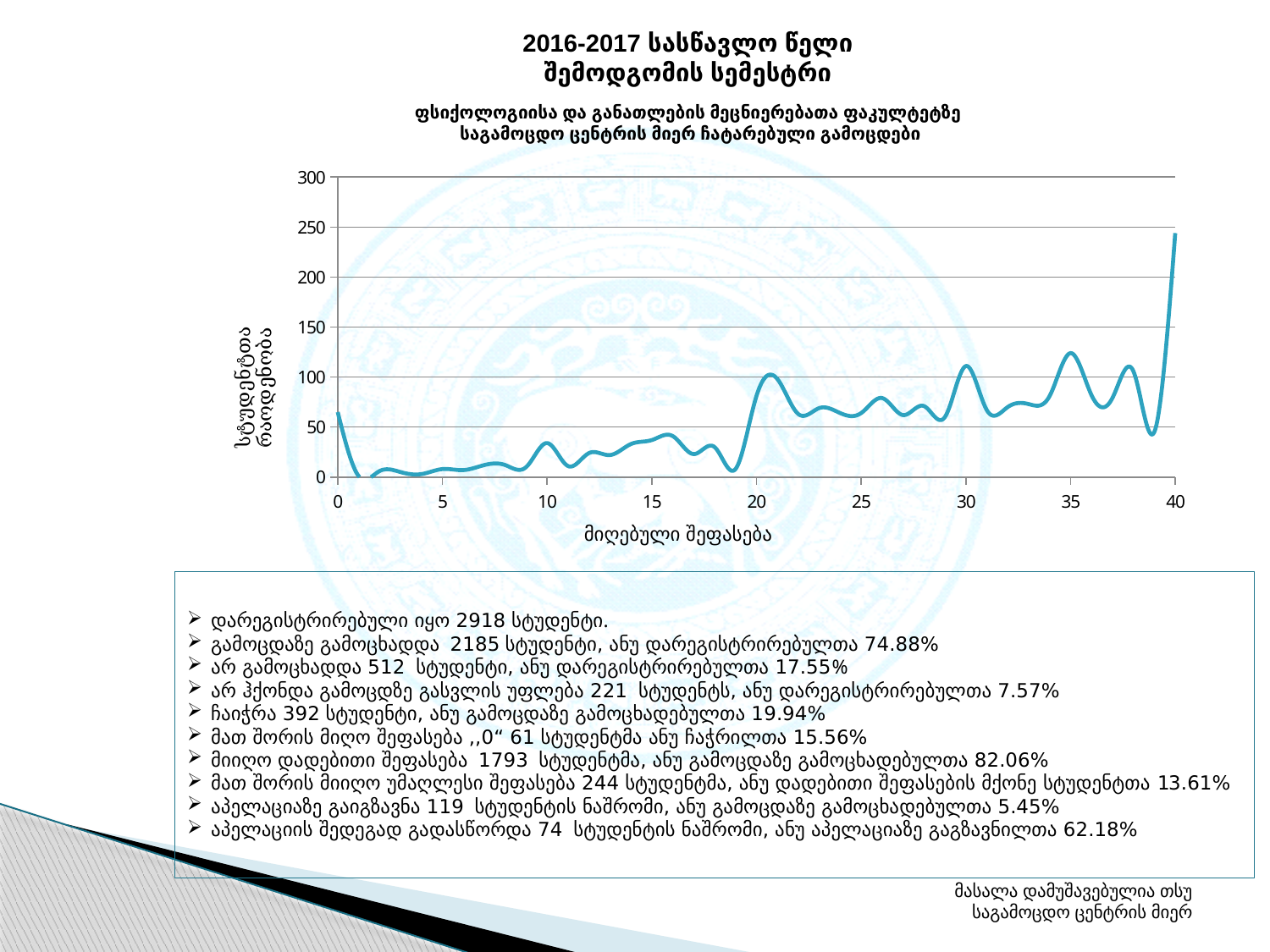
Is the value of the line at x = 35 greater or less than 100? greater Does the line rise or fall between x = 0 and x = 1? fall Is the value of the line at x = 5 greater or less than 50? less Is the value of the line at x = 40 greater or less than 200? greater What kind of chart is shown on the slide? line chart What is the title of the x axis? მიღებული შეფასება Which is larger, the value of the line at x = 40 or at x = 20? x = 40 Which is larger, the value of the line at x = 35 or at x = 10? x = 35 At which x-axis value (მიღებული შეფასება) does the line reach its highest point? 40 What is the title of the y axis? სტუდენტთა რაოდენობა